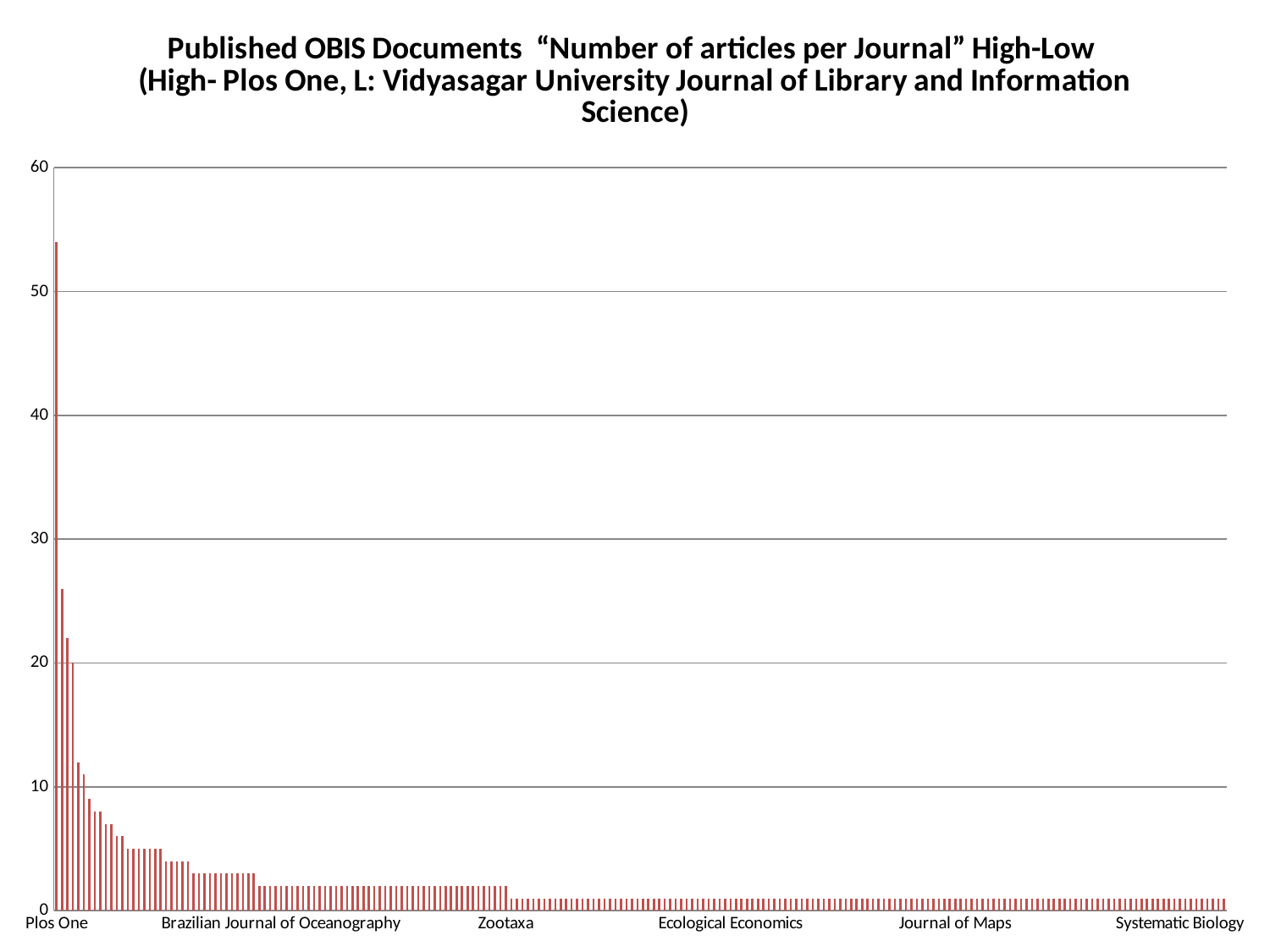
What kind of chart is shown on the slide? Bar chart Is the value for Zootaxa greater or less than 10? less Is the value for Systematic Biology greater or less than 10? less Is the value for Brazilian Journal of Oceanography greater or less than 10? less Which has more articles, Plos One or Zootaxa? Plos One Do the values rise or fall moving from left to right along the x axis? Fall Which journal has the highest number of articles in the chart? Plos One Which has more articles, Brazilian Journal of Oceanography or Zootaxa? Neither; they have the same number of articles What is the highest value shown on the y axis? 60 According to the chart title, which journal has the lowest number of articles? Vidyasagar University Journal of Library and Information Science